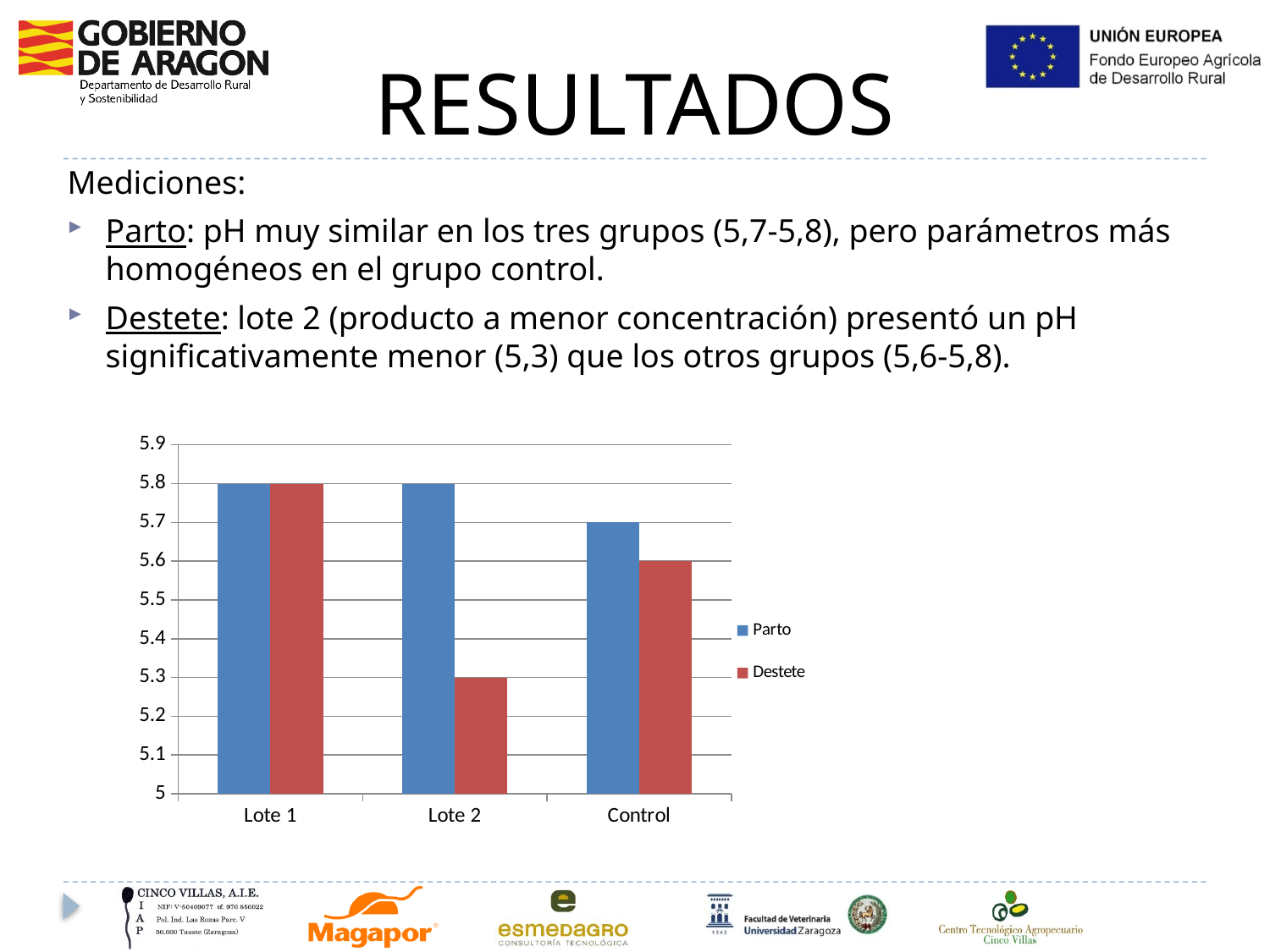
Which category has the lowest Destete value? Lote 2 What is the difference between the Parto and Destete values for Lote 2? 0.5 Which category has the lowest Parto value? Control How many categories are shown on the x axis of the chart? 3 What is the Parto value for Lote 2? 5.8 How many series does the chart legend list? 2 What is the Parto value for Control? 5.7 What kind of chart is shown on the slide? bar chart For Control, which is larger, the Parto value or the Destete value? Parto Which series is shown in red in the chart? Destete What is the Destete value for Lote 2? 5.3 What is the Destete value for Control? 5.6